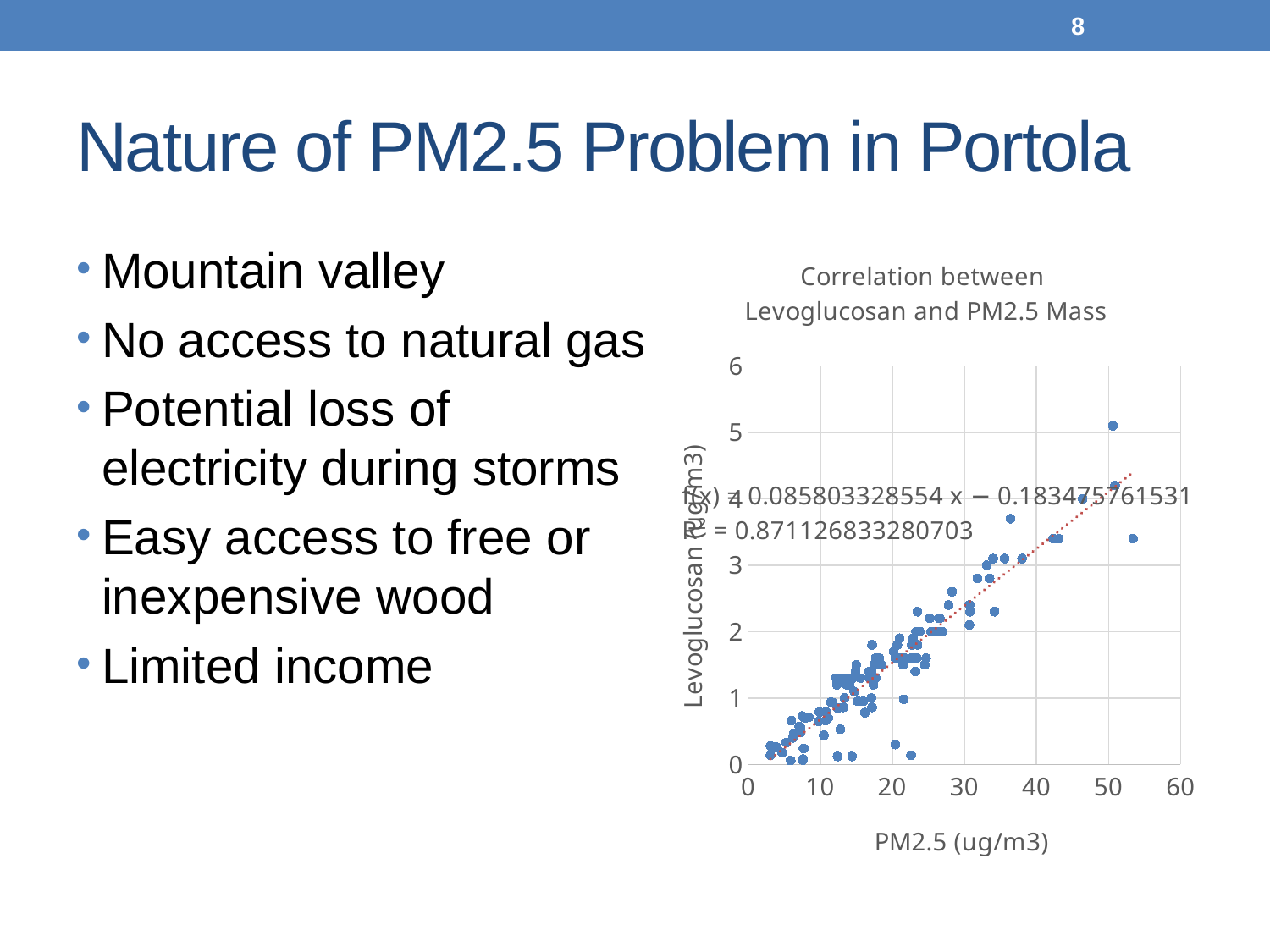
What R² value is printed on the chart? 0.871126833280703 Is the R² value printed on the chart greater or less than 0.8? greater As PM2.5 increases along the x axis, do the Levoglucosan values generally rise or fall? rise What is the highest tick value shown on the x axis of the chart? 60 Is the slope of the trendline equation printed on the chart greater or less than 0.1? less What is the title of the chart? Correlation between Levoglucosan and PM2.5 Mass What kind of chart is shown on the slide? scatter chart What is the label of the x axis of the chart? PM2.5 (ug/m3) Is the Levoglucosan value of the highest point on the chart greater or less than 4? greater What is the highest tick value shown on the y axis of the chart? 6